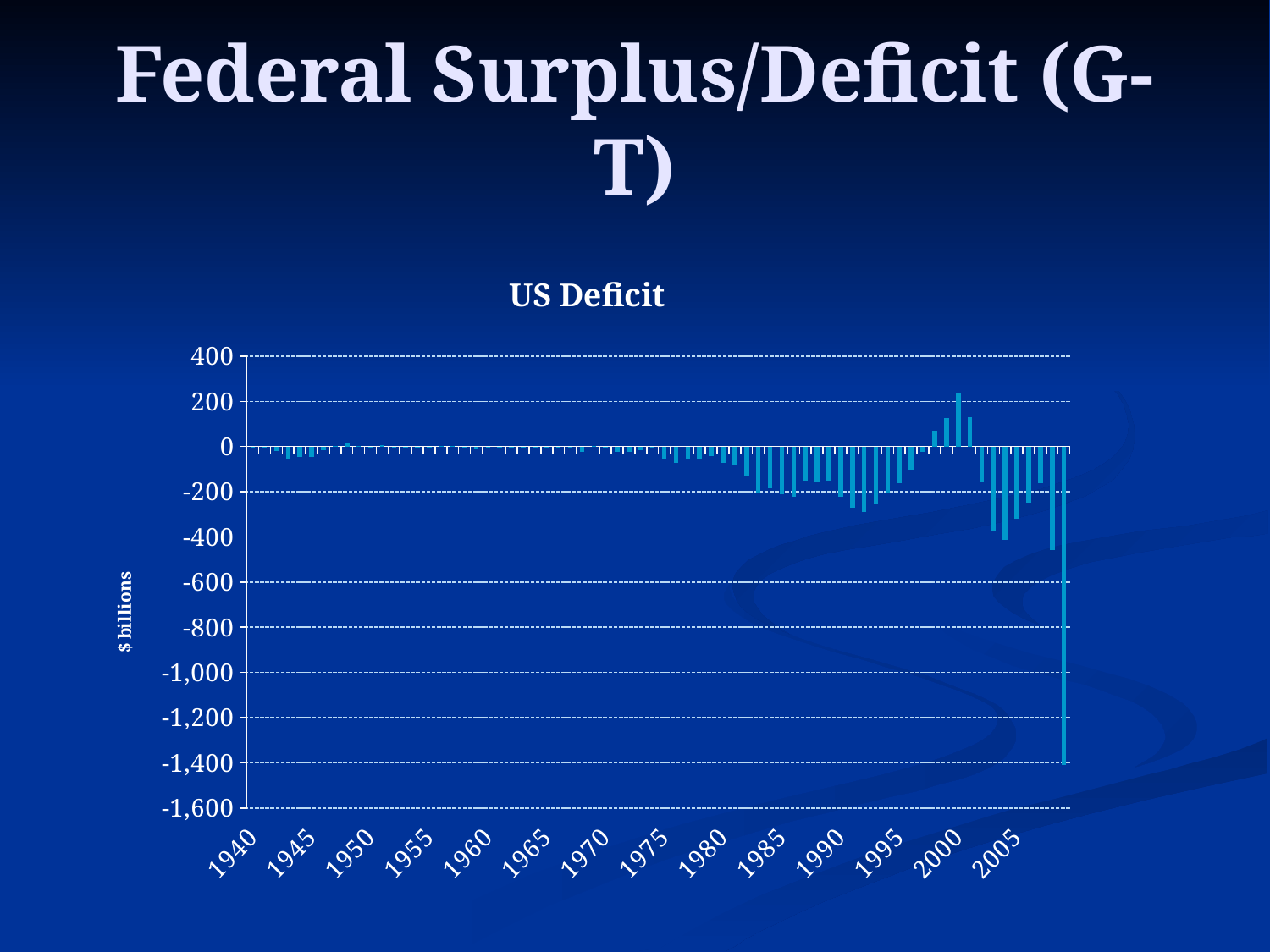
In the US Deficit chart, do the values rise or fall between 1995 and 2000? rise In the US Deficit chart, which is larger, the value for 1945 or the value for 2005? 1945 Is the value for 2005 in the US Deficit chart greater or less than -200? less Is the value of the lowest bar in the US Deficit chart greater or less than -1,200? less Is the value for 1985 in the US Deficit chart greater or less than -100? less In the US Deficit chart, which is larger, the value for 1985 or the value for 2000? 2000 What is the label on the vertical axis of the US Deficit chart? $ billions What is the title of the chart on the slide? US Deficit What kind of chart is the US Deficit chart? bar chart